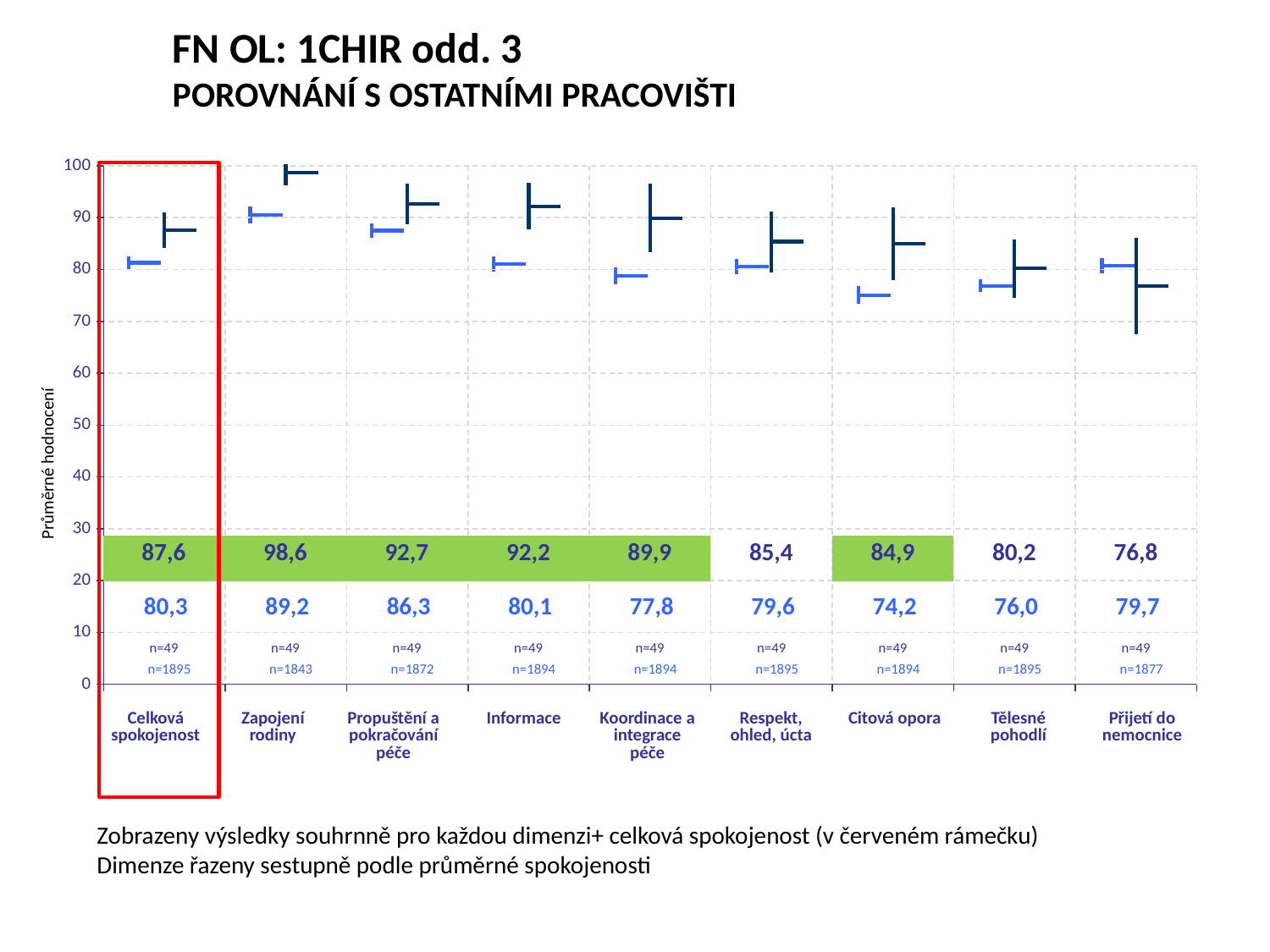
For Přijetí do nemocnice, which is larger: the dark blue value (upper row) or the light blue value (lower row)? light blue (79,7) What is the difference between the dark blue and light blue values for Koordinace a integrace péče? 12,1 Which category has the lowest light blue value (lower row)? Citová opora Which category has the highest dark blue value (upper row, n=49)? Zapojení rodiny What is the n value printed in dark blue for each category? n=49 Is the dark blue value for Informace greater or less than 90? greater What is the light blue value (lower row) for Citová opora? 74,2 What is the dark blue value (upper row, n=49) for Zapojení rodiny? 98,6 What is the dark blue value (upper row, n=49) for Celková spokojenost? 87,6 How many categories (dimensions) are shown on the x axis? 9 Which category is highlighted with a red frame? Celková spokojenost What is the label of the y axis? Průměrné hodnocení